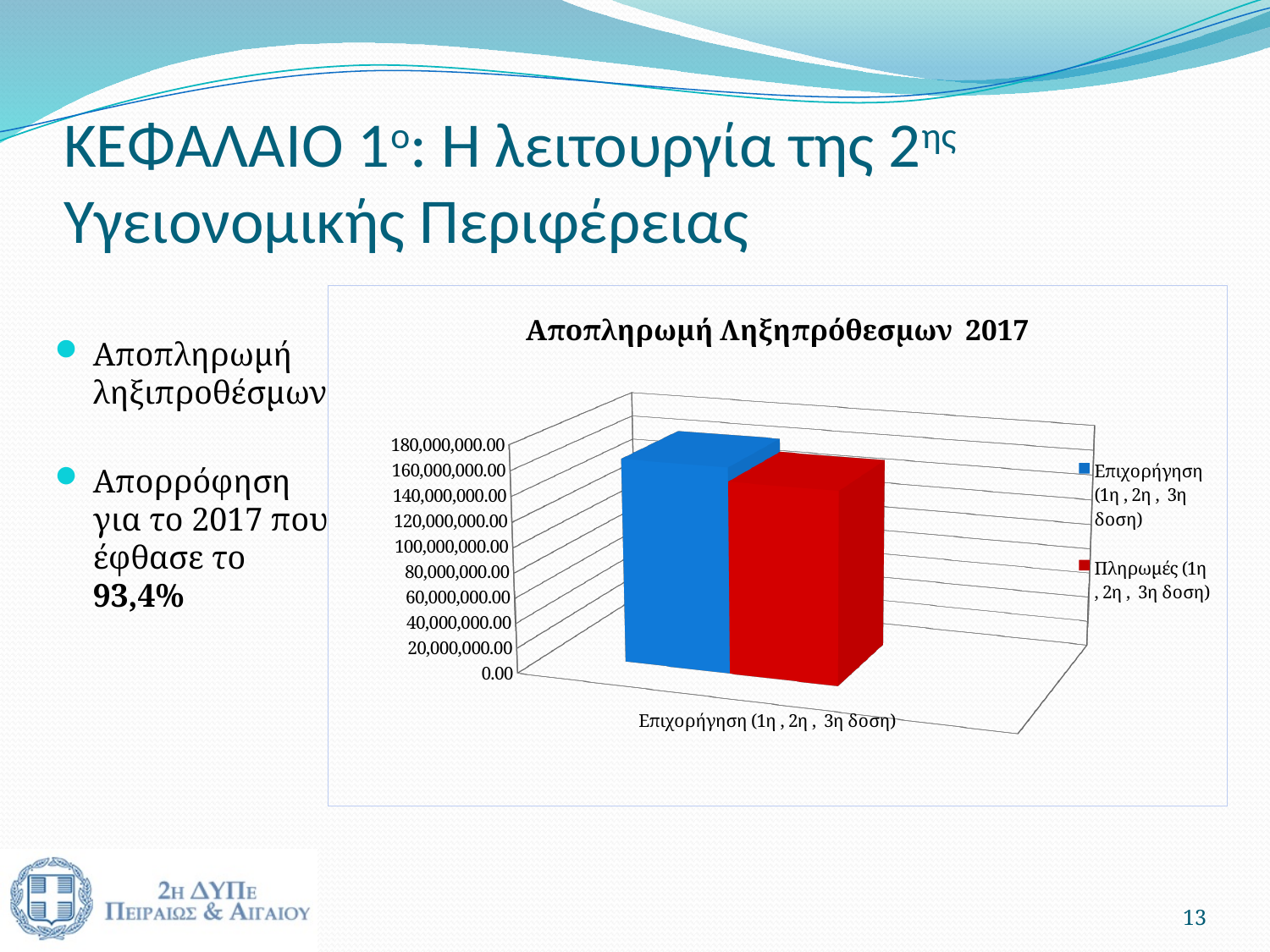
Is the value for 'Επιχορήγηση (1η, 2η, 3η δοση)' greater or less than 180,000,000.00? less Is the value for 'Πληρωμές (1η, 2η, 3η δοση)' greater or less than 180,000,000.00? less Which series has the taller bar, 'Επιχορήγηση (1η, 2η, 3η δοση)' or 'Πληρωμές (1η, 2η, 3η δοση)'? Επιχορήγηση (1η, 2η, 3η δοση) How many series does the chart legend list? 2 How many categories are shown on the x axis of the chart? 1 Is the value for 'Πληρωμές (1η, 2η, 3η δοση)' greater or less than 120,000,000.00? greater What is the highest value shown on the y axis of the chart? 180,000,000.00 Which colour represents the series 'Πληρωμές (1η, 2η, 3η δοση)' in the chart? Red What kind of chart is shown on the slide? Bar chart What is the title of the chart? Αποπληρωμή Ληξηπρόθεσμων 2017